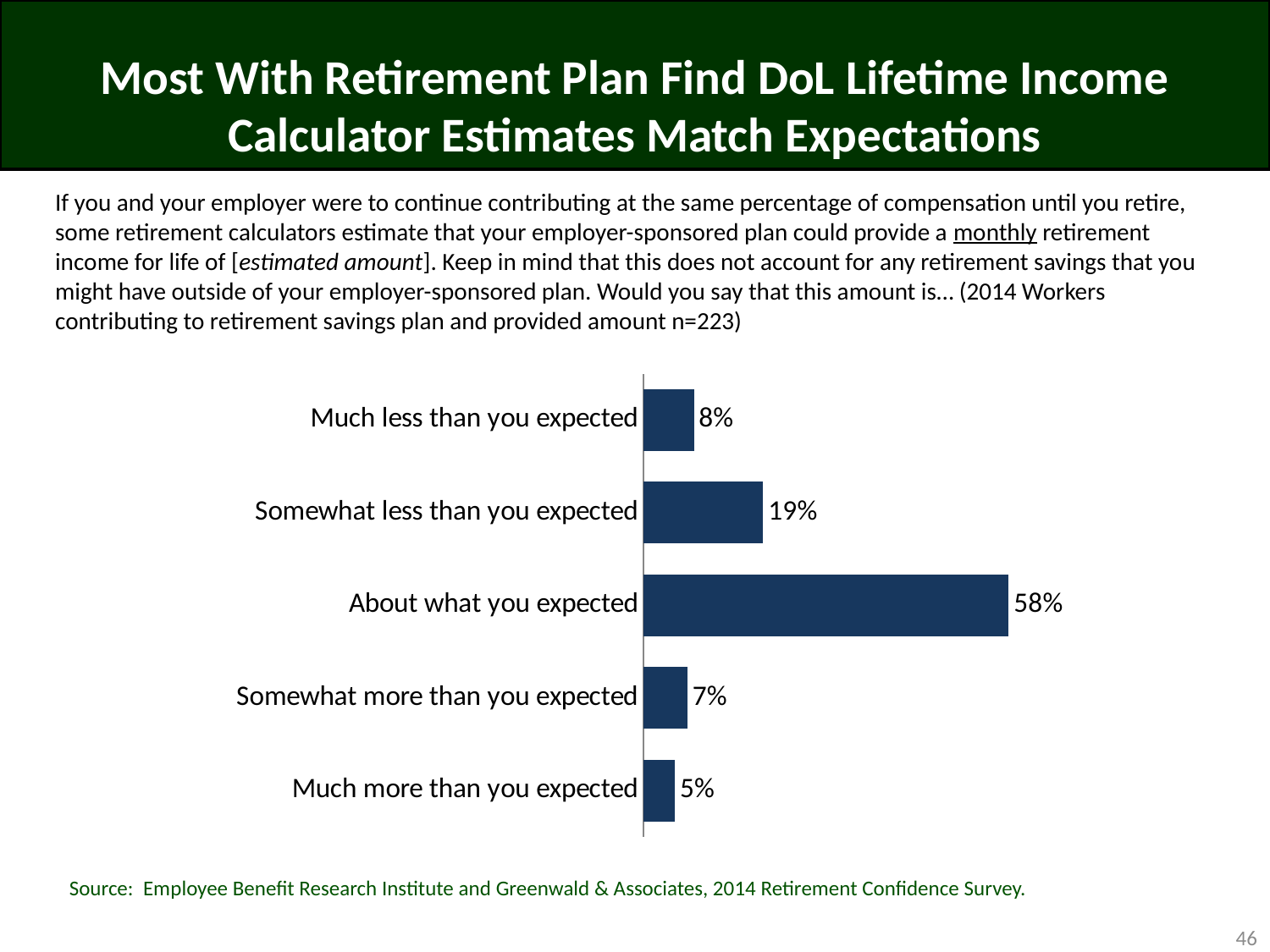
What percentage of respondents said the estimated amount was much more than they expected? 5% What percentage of respondents said the estimated amount was about what they expected? 58% How many response categories are shown in the chart? 5 What is the combined percentage of respondents who said the amount was somewhat less or much less than they expected? 27% What percentage of respondents said the estimated amount was somewhat less than they expected? 19% Which is larger: the percentage for 'Much less than you expected' or 'Much more than you expected'? Much less than you expected Which response category has the lowest percentage? Much more than you expected What type of chart is shown on the slide? Bar chart What is the sample size (n) stated for the survey question on the slide? 223 Which response category has the highest percentage? About what you expected What percentage of respondents said the estimated amount was much less than they expected? 8% What is the difference in percentage points between 'Somewhat less than you expected' and 'Somewhat more than you expected'? 12